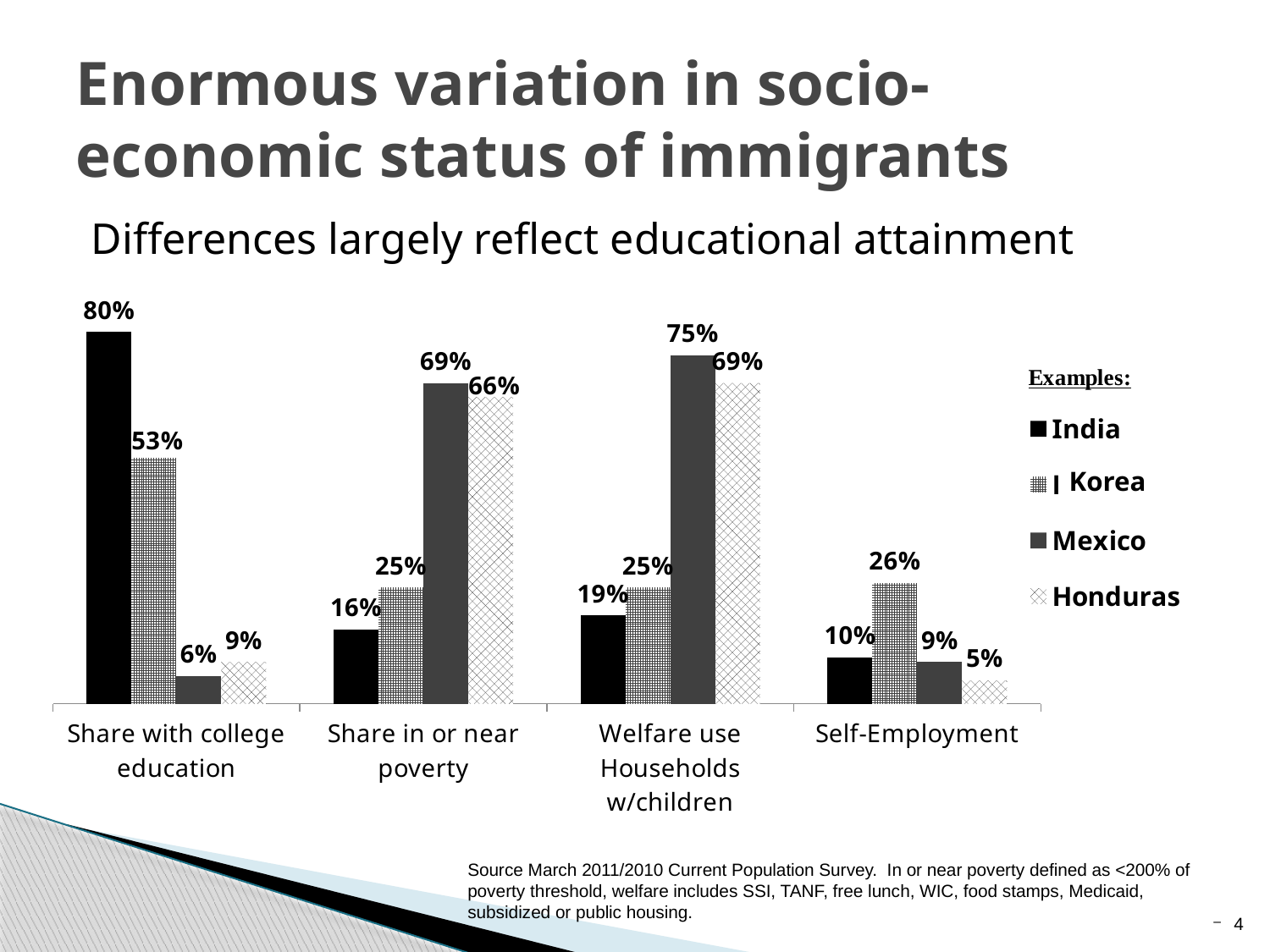
What is the value for Mexico in the Welfare use Households w/children category? 75% Which series is shown with solid black bars? India What kind of chart is shown on the slide? Bar chart What is the value for Korea in the Self-Employment category? 26% What is the difference between India's and Korea's values in the Share with college education category? 27% What is the value for Honduras in the Share in or near poverty category? 66% Which series has the lowest value in the Self-Employment category? Honduras How many series does the legend list? 4 How many categories are shown on the x axis? 4 Which is larger in the Share in or near poverty category: the value for Mexico or the value for Honduras? Mexico What is the value for India in the Share with college education category? 80% Which series has the highest value in the Share with college education category? India